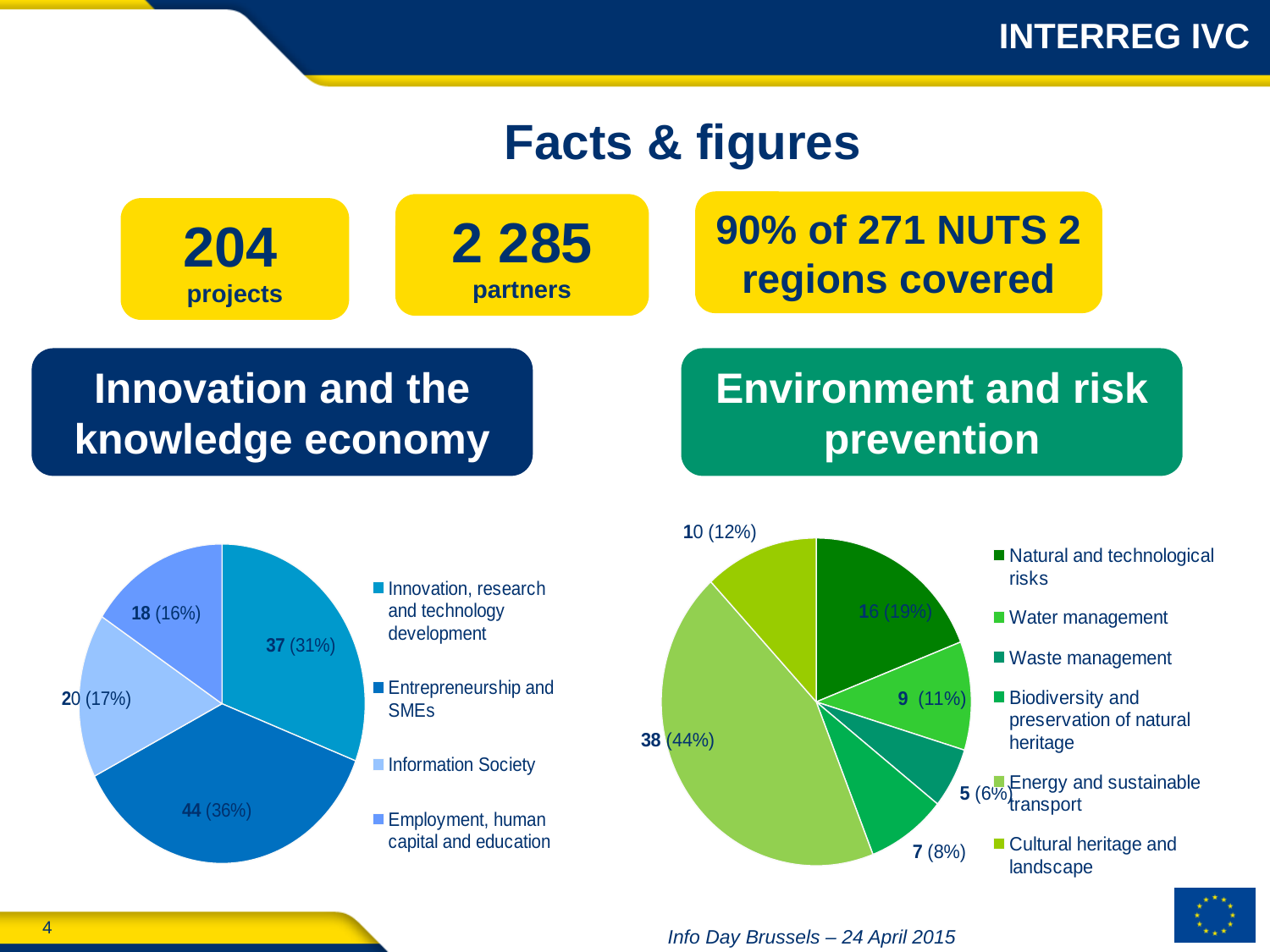
How many categories does the legend of the 'Environment and risk prevention' chart list? 6 In the 'Innovation and the knowledge economy' pie chart, what share of the pie is Information Society? 17% In the 'Environment and risk prevention' pie chart, which category has the smallest slice? Waste management In the 'Environment and risk prevention' pie chart, which is larger: Water management or Cultural heritage and landscape? Cultural heritage and landscape In the 'Innovation and the knowledge economy' pie chart, which category has the largest slice? Entrepreneurship and SMEs In the 'Innovation and the knowledge economy' pie chart, what is the difference between the Entrepreneurship and SMEs count and the Innovation, research and technology development count? 7 In the 'Environment and risk prevention' pie chart, how many projects are in Energy and sustainable transport? 38 In the 'Innovation and the knowledge economy' pie chart, which category has the smallest slice? Employment, human capital and education In the 'Environment and risk prevention' pie chart, what share of the pie is Natural and technological risks? 19% What type of chart is used for 'Environment and risk prevention'? Pie chart In the 'Innovation and the knowledge economy' pie chart, how many projects are in Entrepreneurship and SMEs? 44 How many categories does the 'Innovation and the knowledge economy' pie chart show? 4